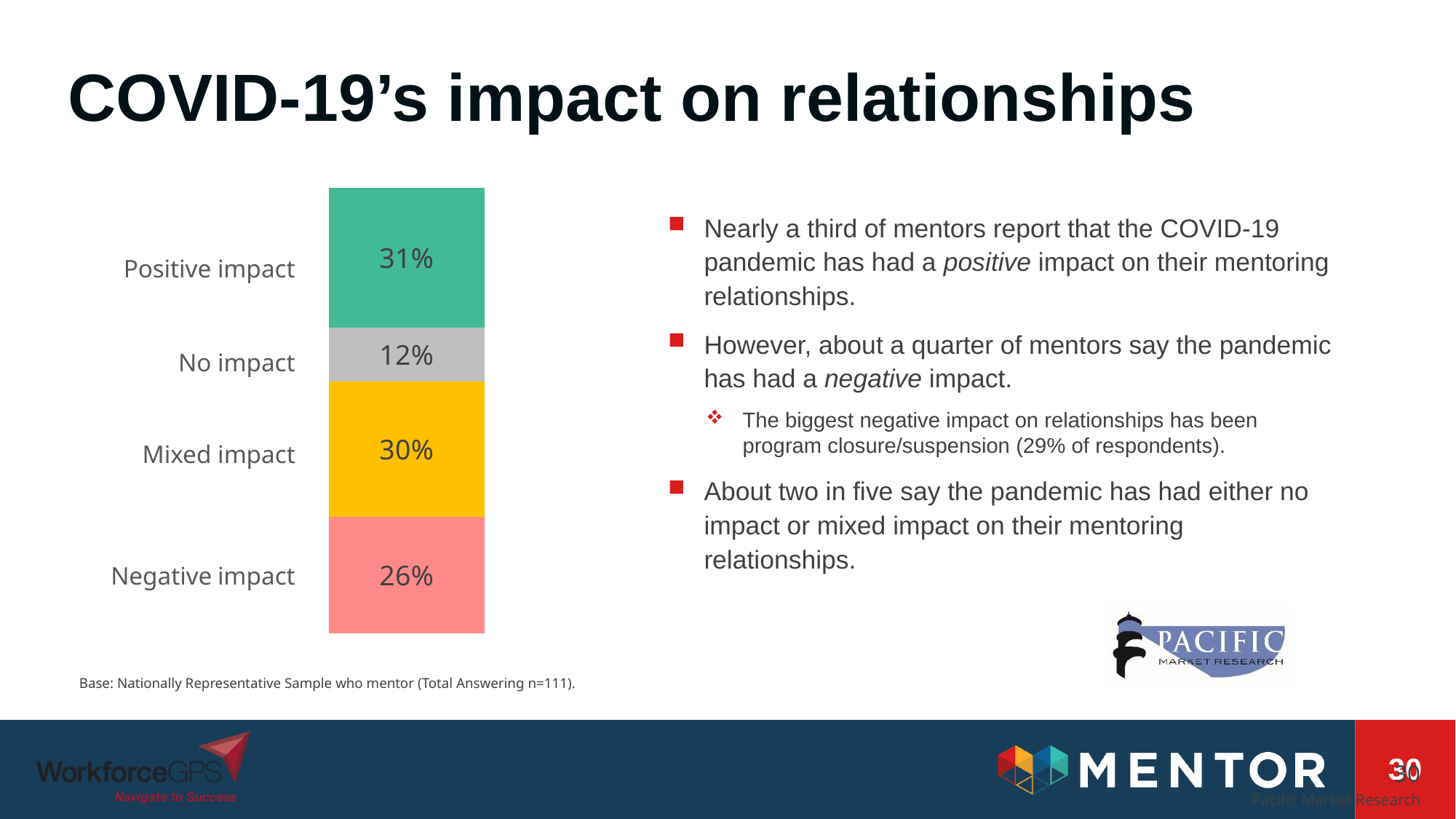
Which category has the smallest share in the chart? No impact What kind of chart is shown on the slide? Stacked bar chart What percentage of mentors report a positive impact? 31% What is the difference in percentage points between Mixed impact and No impact? 18 percentage points What is the value shown for No impact? 12% Which category has the largest share in the chart? Positive impact How many categories are shown in the chart? 4 What percentage of mentors report a mixed impact? 30% Which is larger, the share for Positive impact or the share for Negative impact? Positive impact What is the value shown for Negative impact? 26% What is the difference in percentage points between Positive impact and Negative impact? 5 percentage points What colour is the Negative impact segment of the bar? Pink